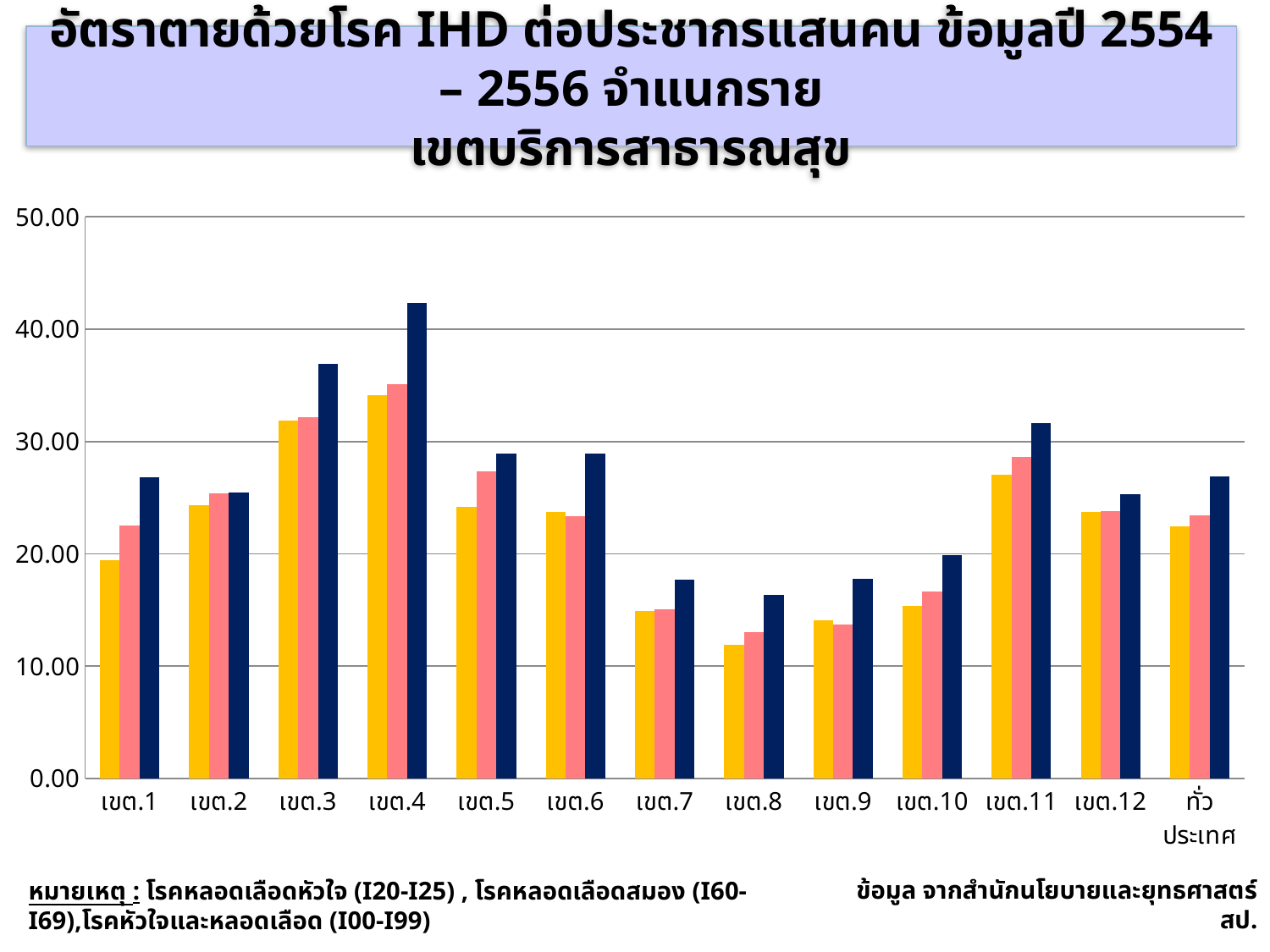
Which category has the shortest yellow bar? เขต.8 Is the dark blue bar for เขต.4 greater or less than 40.00? greater Within เขต.4, do the bars rise or fall from the yellow bar to the dark blue bar? rise What kind of chart is shown on the slide? bar chart Is the dark blue bar for เขต.3 greater or less than 30.00? greater Which is larger: the yellow bar for เขต.1 or the yellow bar for เขต.2? เขต.2 Which is larger: the dark blue bar for เขต.3 or the dark blue bar for เขต.5? เขต.3 Is the yellow bar for เขต.7 greater or less than 20.00? less What is the highest value shown on the y axis of the chart? 50.00 Which category has the tallest dark blue bar? เขต.4 How many categories are shown along the x axis of the chart? 13